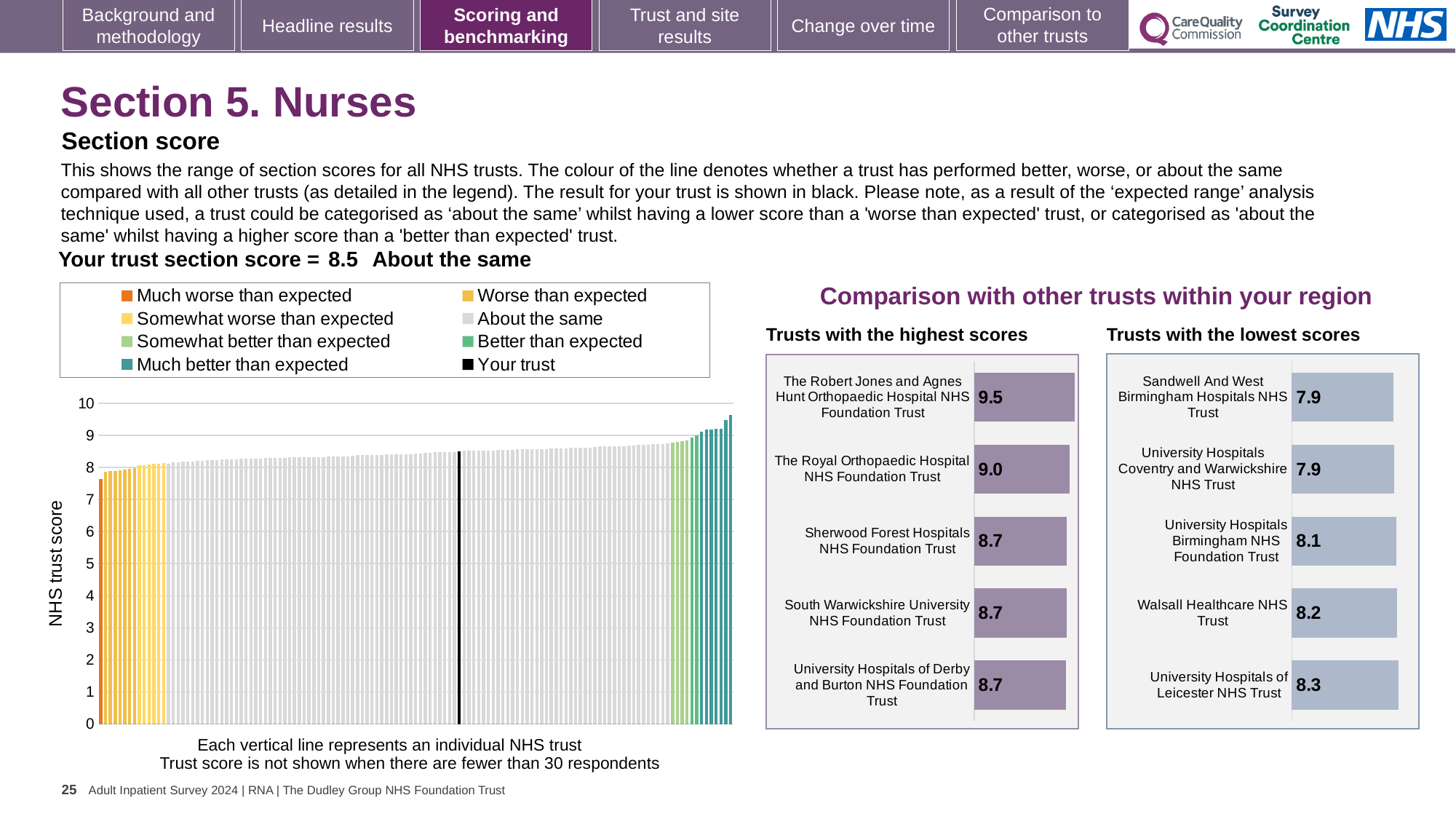
In the 'Trusts with the lowest scores' chart, what is the score for Walsall Healthcare NHS Trust? 8.2 In the 'Trusts with the lowest scores' chart, what is the score for University Hospitals of Leicester NHS Trust? 8.3 In the main 'NHS trust score' chart on the left, is the value of the black 'Your trust' bar greater or less than 8? greater In the main 'NHS trust score' chart on the left, how many entries does the legend list? 8 In the 'Trusts with the highest scores' chart, what is the difference between the scores of The Robert Jones and Agnes Hunt Orthopaedic Hospital NHS Foundation Trust and The Royal Orthopaedic Hospital NHS Foundation Trust? 0.5 What kind of chart is the main 'NHS trust score' chart on the left? Bar chart How many trusts are listed in the 'Trusts with the highest scores' chart? 5 In the 'Trusts with the lowest scores' chart, which has the higher score: Walsall Healthcare NHS Trust or University Hospitals Birmingham NHS Foundation Trust? Walsall Healthcare NHS Trust In the 'Trusts with the highest scores' chart, what is the score for The Royal Orthopaedic Hospital NHS Foundation Trust? 9.0 In the main 'NHS trust score' chart on the left, do the bar values rise or fall from left to right? Rise In the 'Trusts with the lowest scores' chart, what is the difference between the scores of University Hospitals of Leicester NHS Trust and Sandwell And West Birmingham Hospitals NHS Trust? 0.4 In the 'Trusts with the highest scores' chart, what is the score for The Robert Jones and Agnes Hunt Orthopaedic Hospital NHS Foundation Trust? 9.5